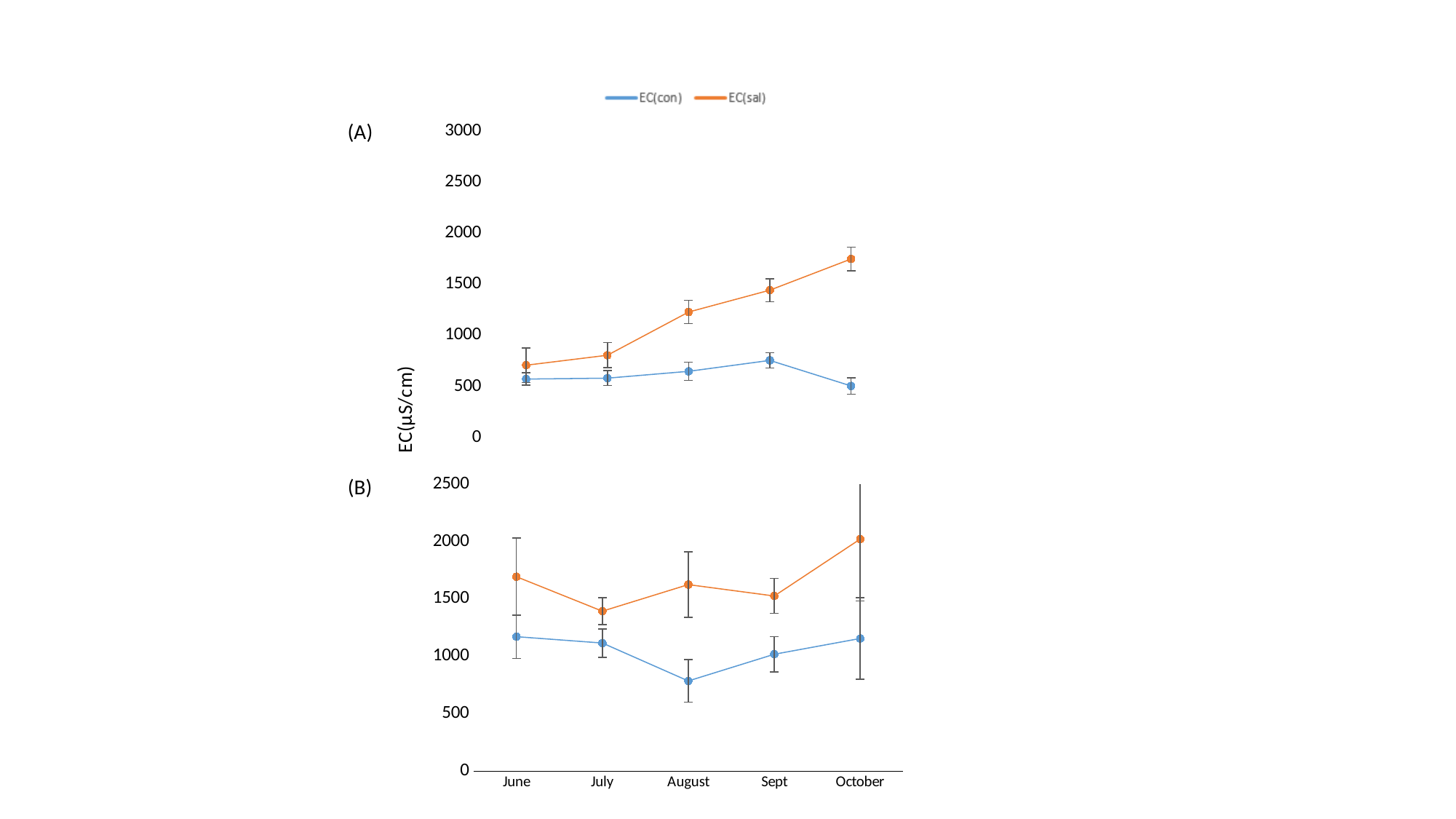
In chart (A), does EC(sal) rise or fall from June to October? rise In chart (A), which month has the lowest EC(con) value? October What is the label on the y axis? EC(μS/cm) In chart (B), which month has the highest EC(sal) value? October In chart (B), is the EC(con) value for August greater or less than 1000? less What kind of chart is chart (A)? line chart How many series does the legend list? 2 In chart (A), which month has the highest EC(sal) value? October In chart (B), which month has the lowest EC(con) value? August In chart (B), which is larger in July, EC(con) or EC(sal)? EC(sal) In chart (A), is the EC(sal) value for October greater or less than 1500? greater How many months are plotted along the x axis of chart (B)? 5